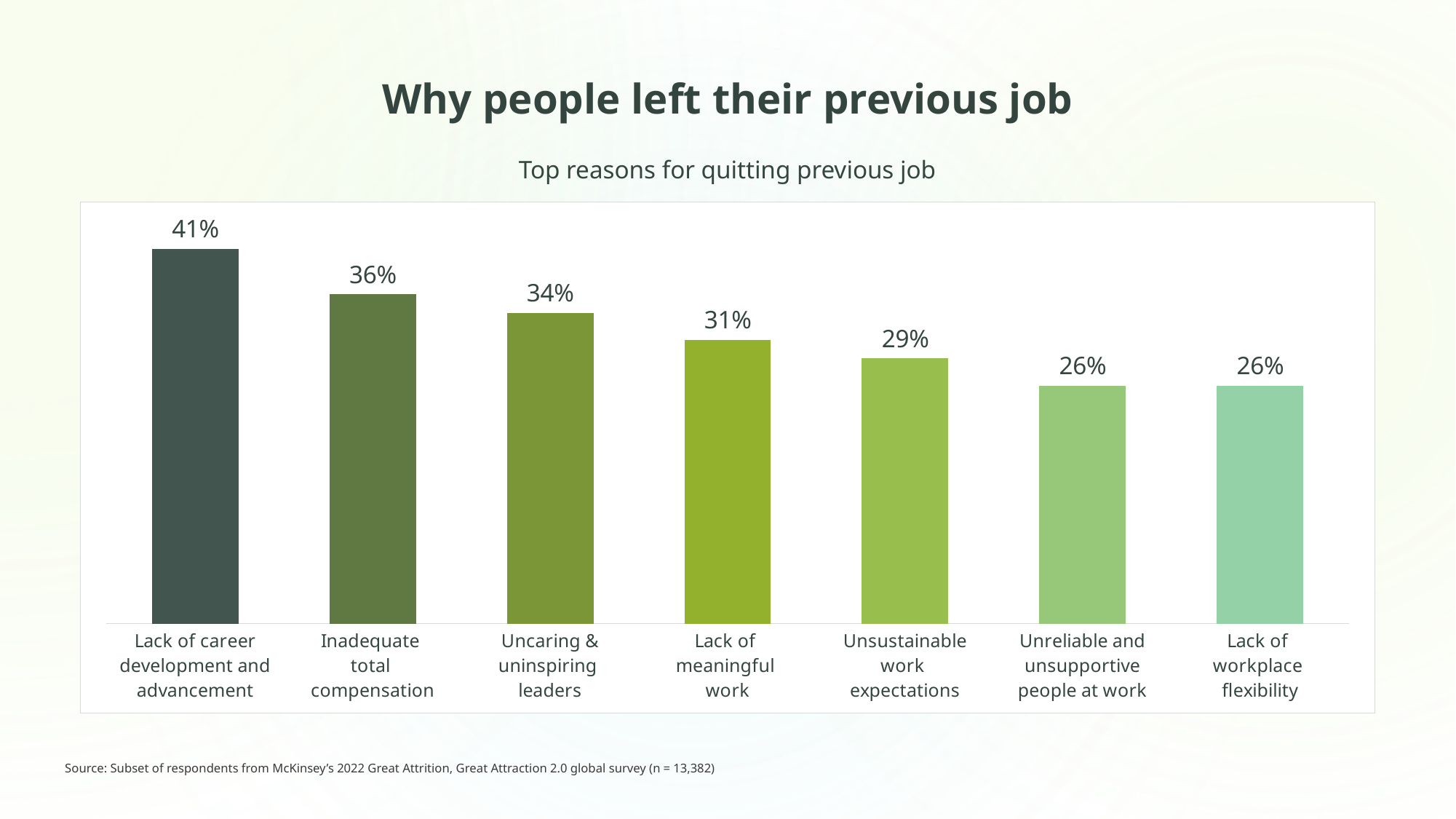
Which reason for quitting has the highest percentage? Lack of career development and advancement How many reasons for quitting are shown on the chart? 7 What is the difference between inadequate total compensation and unsustainable work expectations? 7% Do the values rise or fall moving from left to right across the chart? Fall What is the lowest percentage shown on the chart? 26% What percentage of respondents cited lack of career development and advancement as a reason for quitting? 41% Which is larger: the value for uncaring & uninspiring leaders or the value for lack of workplace flexibility? Uncaring & uninspiring leaders What percentage is shown for uncaring & uninspiring leaders? 34% What is the difference between the values for lack of career development and advancement and lack of meaningful work? 10% What is the value shown for inadequate total compensation? 36% What kind of chart is shown on the slide? Bar chart What is the value for unsustainable work expectations? 29%